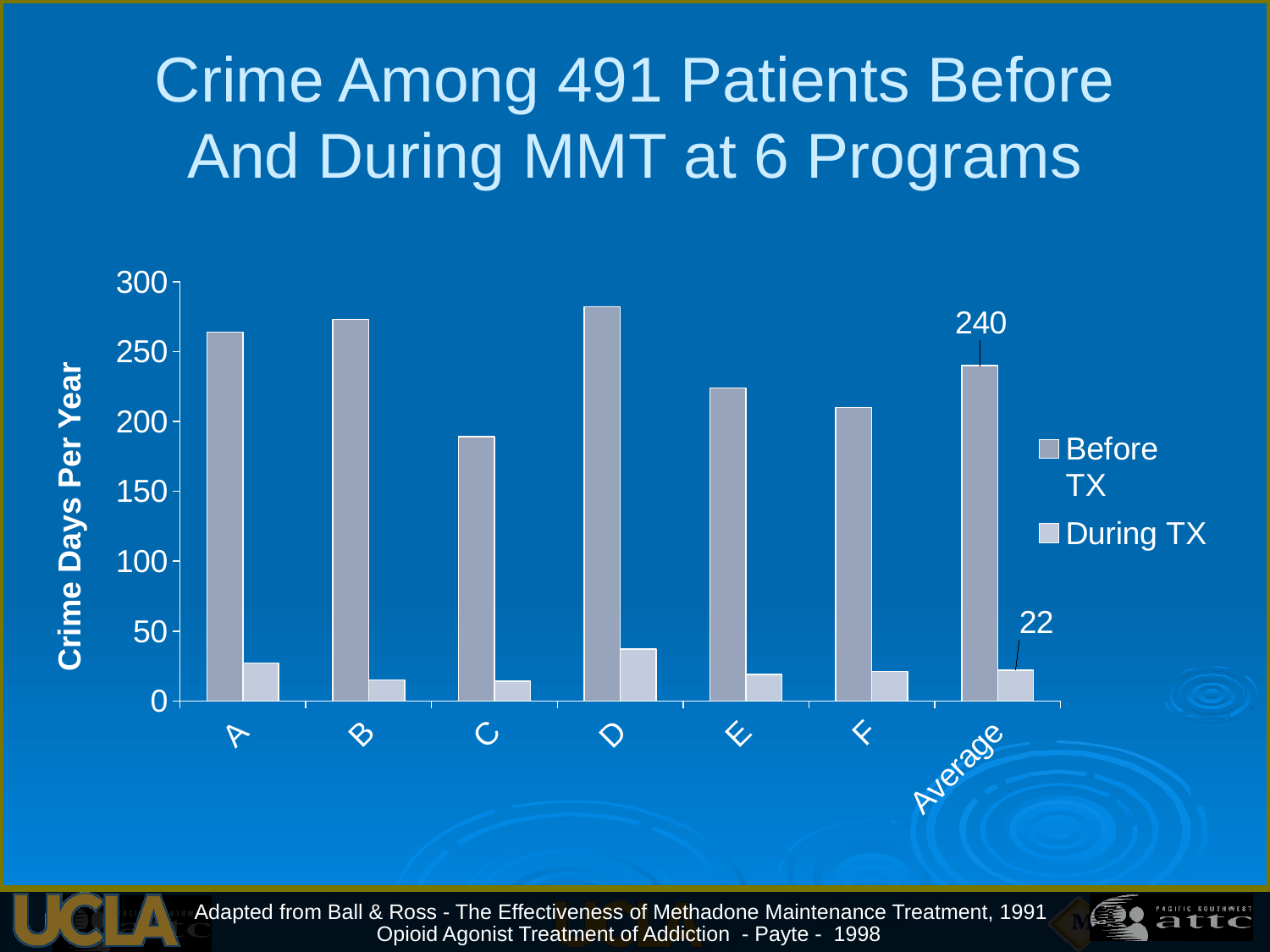
What is the difference between the Before TX and During TX values for Average? 218 How many series does the legend list? 2 Which program has the lowest Before TX value? C Which program has the highest Before TX value? D Is the Before TX value for A greater or less than 250? greater What is the Before TX value for Average? 240 Which program has the highest During TX value? D Which is larger for program E, the Before TX value or the During TX value? Before TX Is the Before TX value for C greater or less than 200? less What kind of chart is shown on the slide? Bar chart Is the During TX value for D greater or less than 50? less What is the During TX value for Average? 22